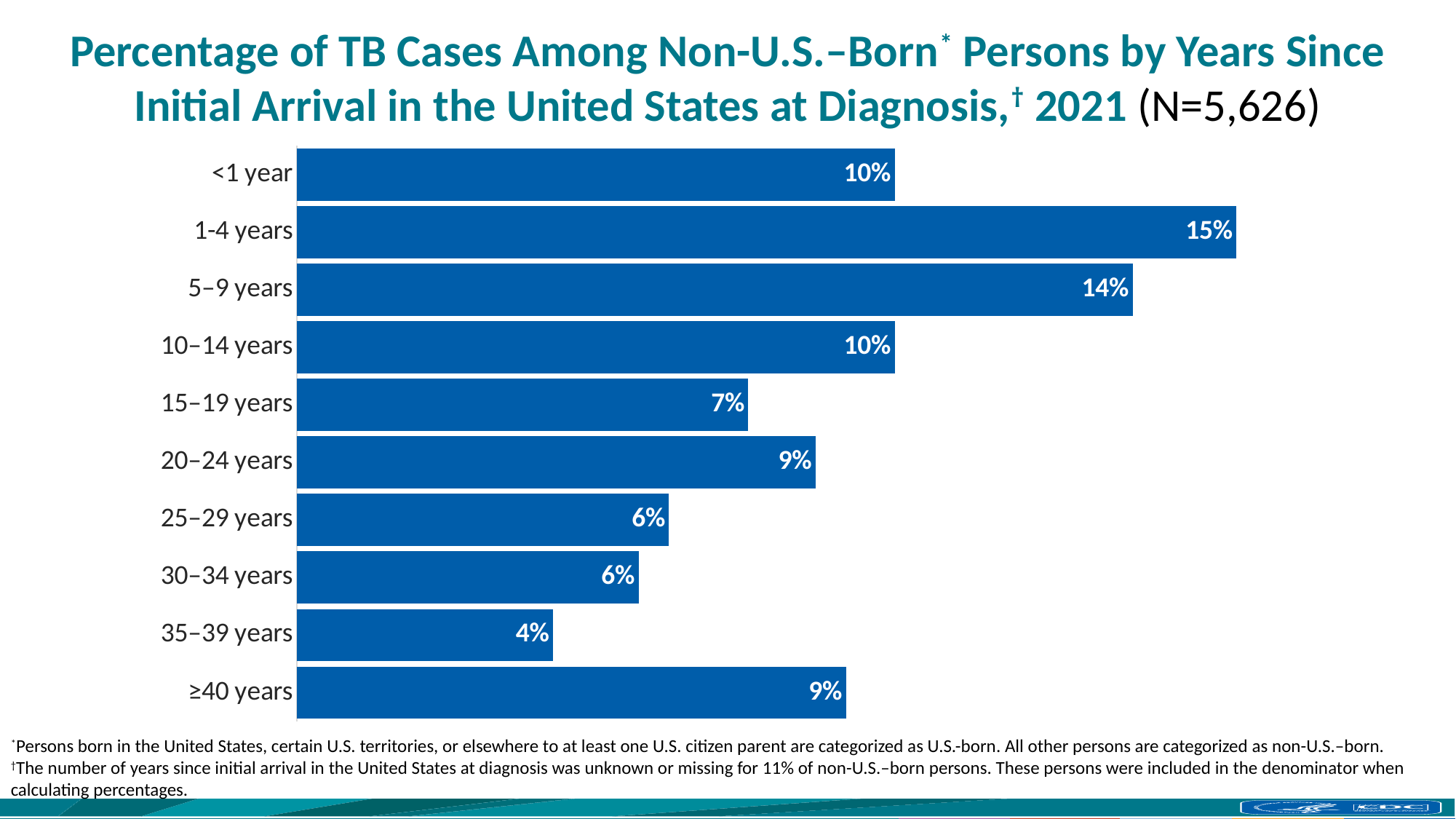
Which years-since-arrival category has the lowest percentage of TB cases? 35–39 years What percentage of TB cases among non-U.S.-born persons were diagnosed 35–39 years since initial arrival? 4% What percentage of TB cases among non-U.S.-born persons were diagnosed ≥40 years since initial arrival? 9% Which years-since-arrival category has the highest percentage of TB cases? 1-4 years What percentage of TB cases among non-U.S.-born persons were diagnosed <1 year since initial arrival? 10% How many years-since-arrival categories are shown in the chart? 10 What is the total number of cases (N) stated in the chart title? 5,626 What percentage of TB cases among non-U.S.-born persons were diagnosed 1-4 years since initial arrival? 15% What type of chart is shown on the slide? Bar chart What is the difference in percentage points between the 10–14 years and 15–19 years categories? 3% What is the difference in percentage points between the 1-4 years and 5–9 years categories? 1% Which category has a larger percentage of TB cases: 20–24 years or 25–29 years? 20–24 years